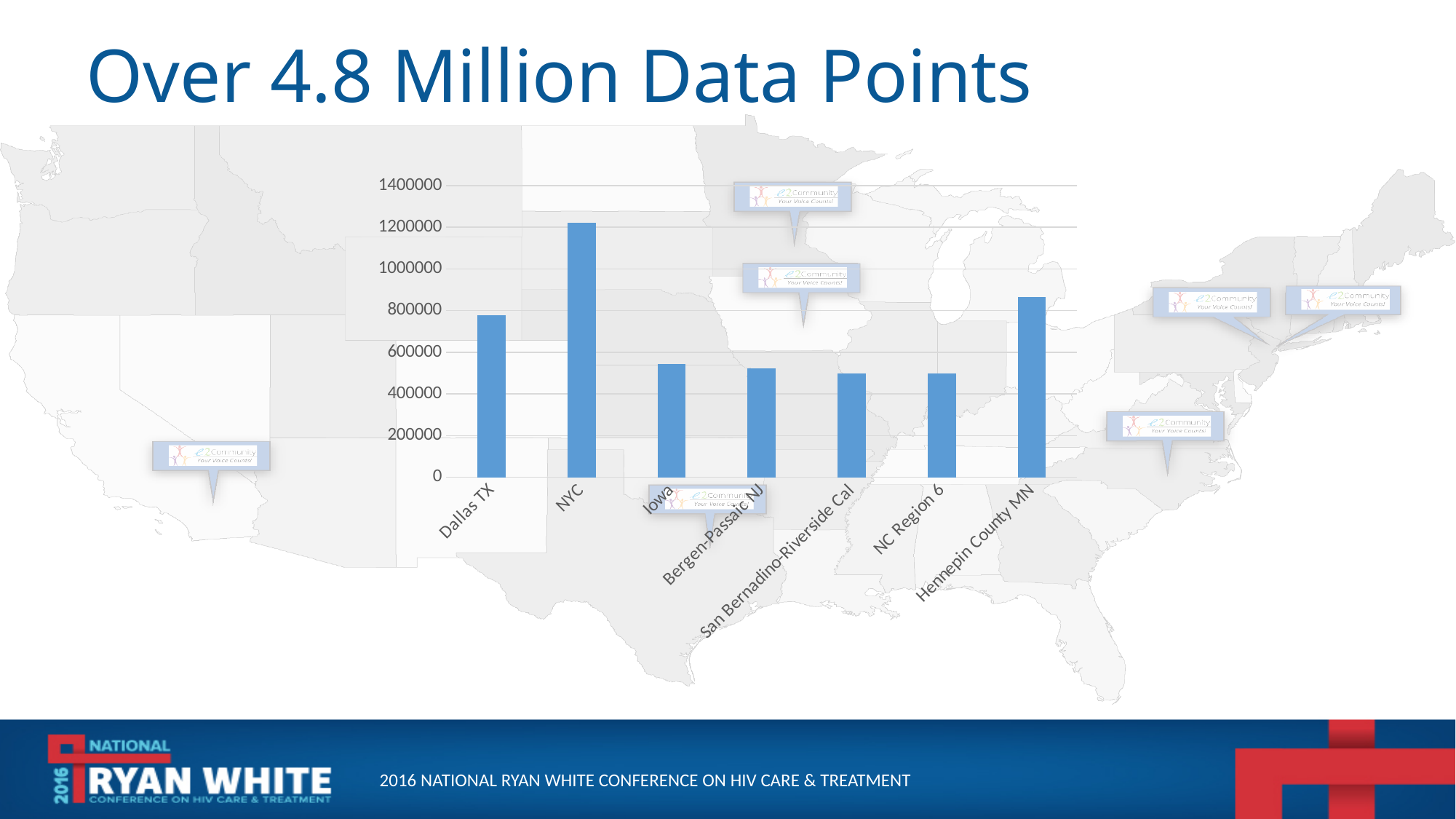
Which is larger, the value for NYC or the value for Dallas TX? NYC How many categories are plotted on the bar chart? 7 What is the highest tick value shown on the vertical axis? 1400000 Which is larger, the value for Hennepin County MN or the value for Dallas TX? Hennepin County MN Is the value for NC Region 6 greater or less than 600000? less What kind of chart is shown on the slide? bar chart Is the value for NYC greater or less than 1000000? greater Which is larger, the value for Dallas TX or the value for Iowa? Dallas TX Is the value for Iowa greater or less than 600000? less Which category has the highest bar? NYC